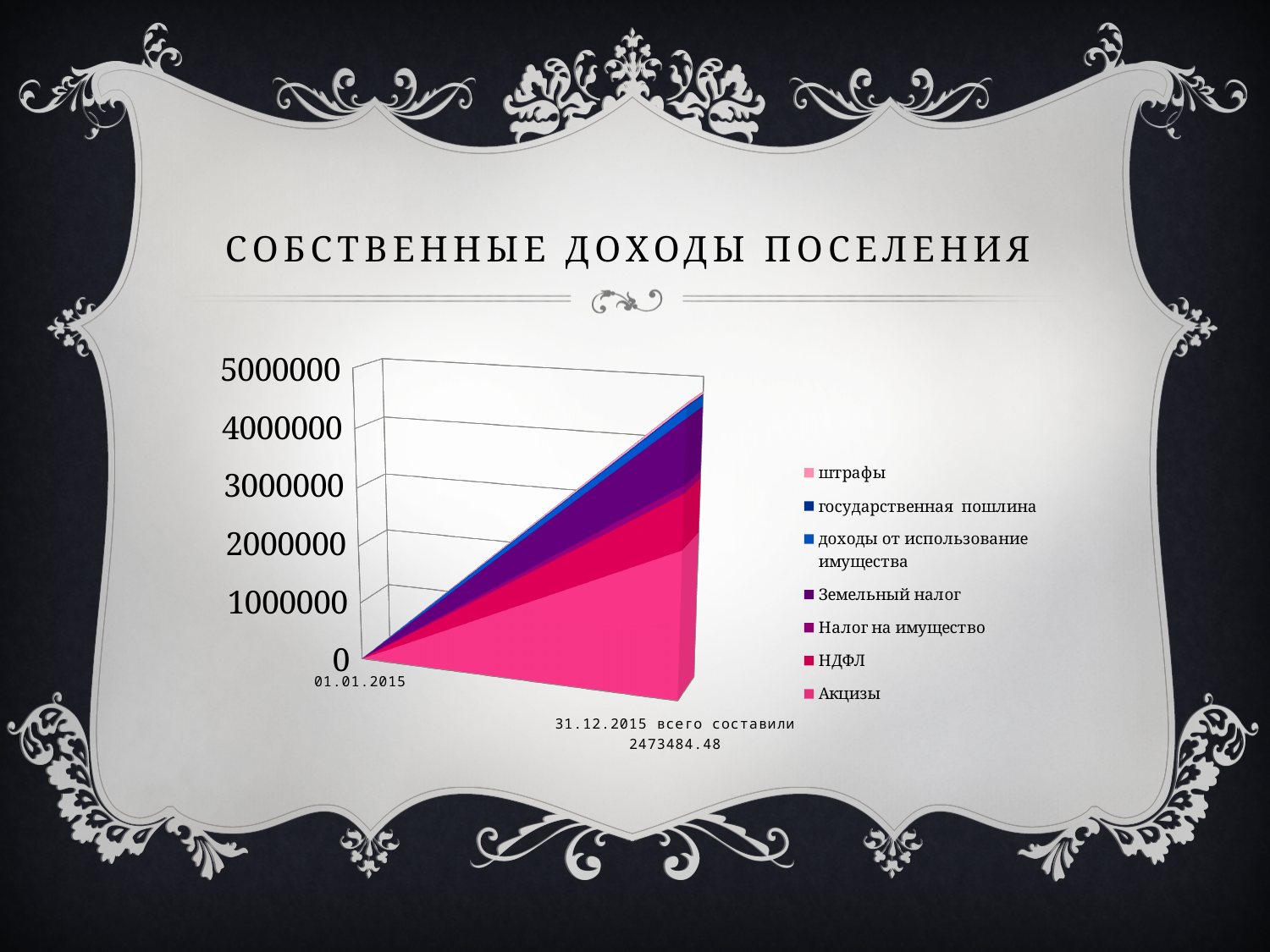
Which series is listed first in the legend? штрафы Is the total height of the stacked areas at 31.12.2015 greater or less than 5000000? less What kind of chart is shown on the slide? area chart What is the highest value shown on the y axis? 5000000 Do the stacked values rise or fall from 01.01.2015 to 31.12.2015? rise Which series occupies the largest area at 31.12.2015? Акцизы How many dates are shown along the x axis? 2 How many series does the legend list? 7 Is the total height of the stacked areas at 01.01.2015 greater or less than 1000000? less What is the title of the chart? СОБСТВЕННЫЕ ДОХОДЫ ПОСЕЛЕНИЯ At 31.12.2015, which is larger: Акцизы or НДФЛ? Акцизы Is the total height of the stacked areas at 31.12.2015 greater or less than 4000000? greater